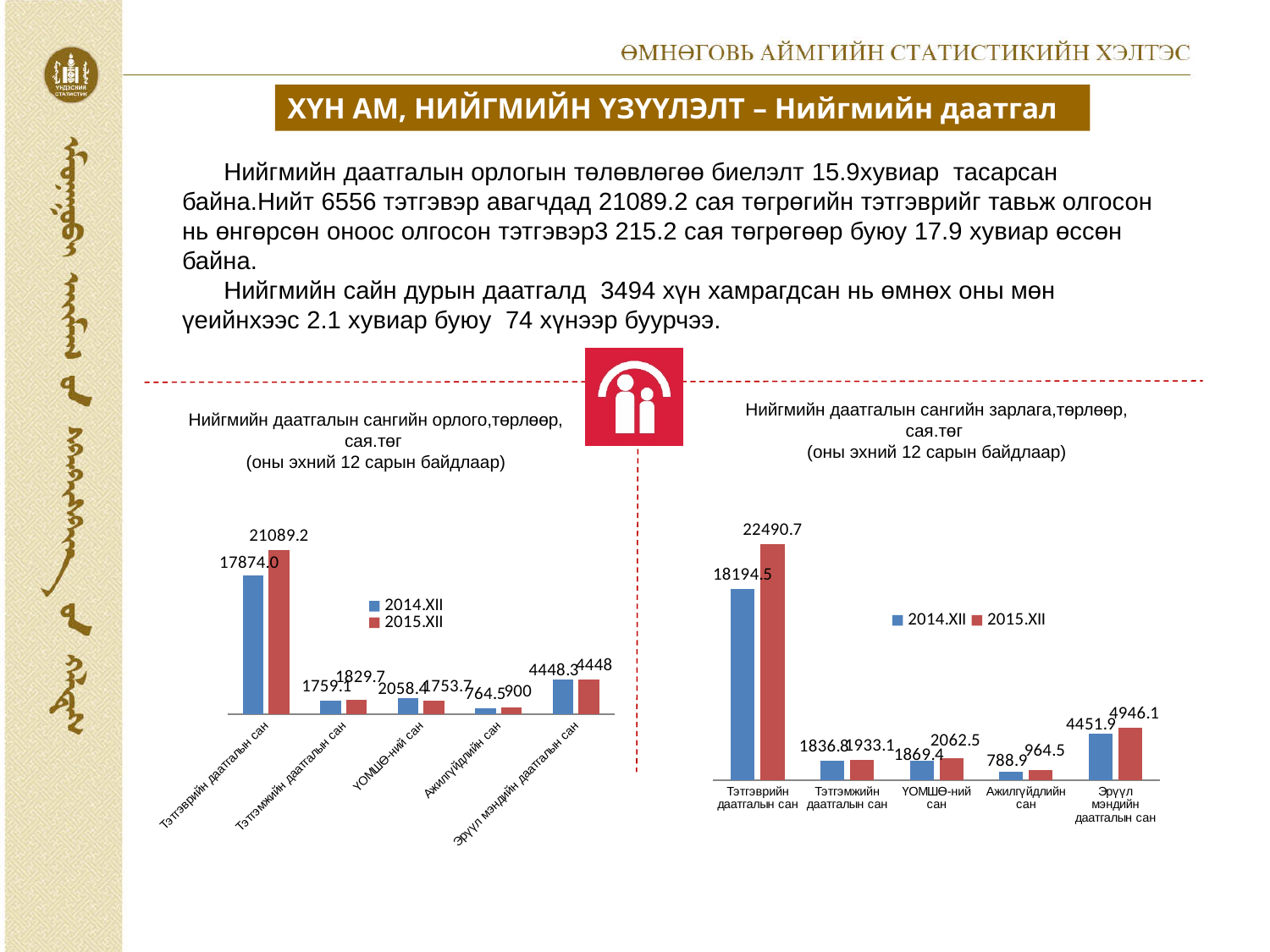
What type of chart is the right chart (Нийгмийн даатгалын сангийн зарлага)? Bar chart How many series does the legend of the left chart (Нийгмийн даатгалын сангийн орлого) list? 2 How many categories are shown in the right chart (Нийгмийн даатгалын сангийн зарлага)? 5 In the left chart (Нийгмийн даатгалын сангийн орлого), which is larger for ҮОМШӨ-ний сан: the 2014.XII value or the 2015.XII value? 2014.XII In the right chart (Нийгмийн даатгалын сангийн зарлага), what is the 2014.XII value for ҮОМШӨ-ний сан? 1869.4 In the right chart (Нийгмийн даатгалын сангийн зарлага), which category has the highest 2015.XII value? Тэтгэврийн даатгалын сан In the left chart (Нийгмийн даатгалын сангийн орлого), what is the 2015.XII value for Тэтгэврийн даатгалын сан? 21089.2 In the right chart (Нийгмийн даатгалын сангийн зарлага), what is the difference between the 2015.XII and 2014.XII values for Тэтгэврийн даатгалын сан? 4296.2 In the left chart (Нийгмийн даатгалын сангийн орлого), which colour represents the 2015.XII series? Red In the right chart (Нийгмийн даатгалын сангийн зарлага), what is the 2015.XII value for Эрүүл мэндийн даатгалын сан? 4946.1 In the left chart (Нийгмийн даатгалын сангийн орлого), what is the 2014.XII value for Ажилгүйдлийн сан? 764.5 In the left chart (Нийгмийн даатгалын сангийн орлого), which category has the lowest 2014.XII value? Ажилгүйдлийн сан